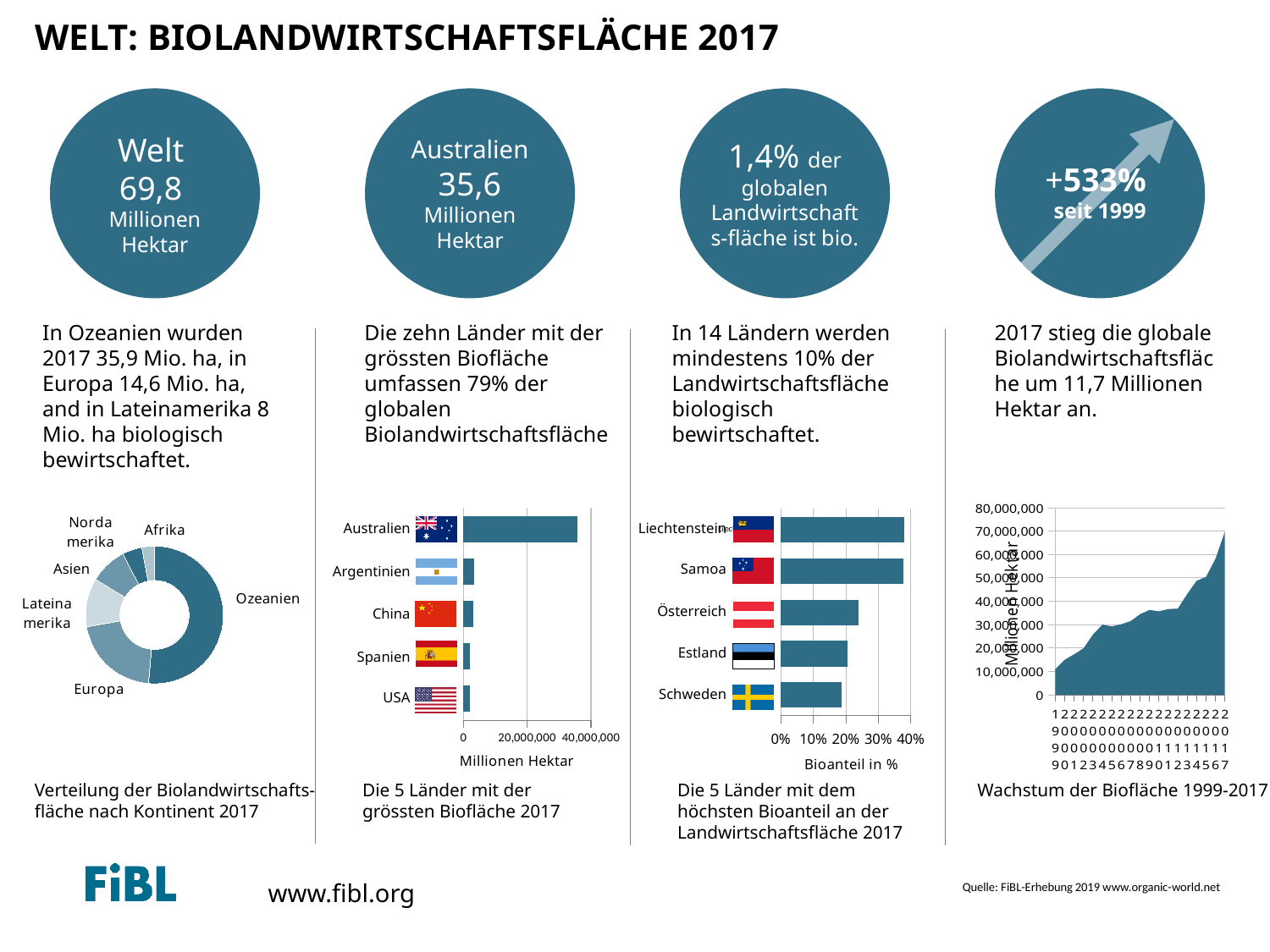
In the chart "Die 5 Länder mit dem höchsten Bioanteil an der Landwirtschaftsfläche 2017", is the value for Liechtenstein greater or less than 30%? greater What kind of chart is "Verteilung der Biolandwirtschaftsfläche nach Kontinent 2017"? doughnut chart In the chart "Die 5 Länder mit dem höchsten Bioanteil an der Landwirtschaftsfläche 2017", which country has the lowest value? Schweden What kind of chart is "Die 5 Länder mit der grössten Biofläche 2017"? bar chart In the chart "Verteilung der Biolandwirtschaftsfläche nach Kontinent 2017", how many continents are shown? 6 In the chart "Verteilung der Biolandwirtschaftsfläche nach Kontinent 2017", which continent has the largest share? Ozeanien In the chart "Wachstum der Biofläche 1999-2017", do the values rise or fall from 1999 to 2017? rise In the chart "Die 5 Länder mit dem höchsten Bioanteil an der Landwirtschaftsfläche 2017", which is larger, Österreich or Schweden? Österreich In the chart "Die 5 Länder mit der grössten Biofläche 2017", which country has the highest value? Australien In the chart "Wachstum der Biofläche 1999-2017", is the value for 2017 greater or less than 60,000,000? greater In the chart "Die 5 Länder mit der grössten Biofläche 2017", is the value for Australien greater or less than 20,000,000? greater